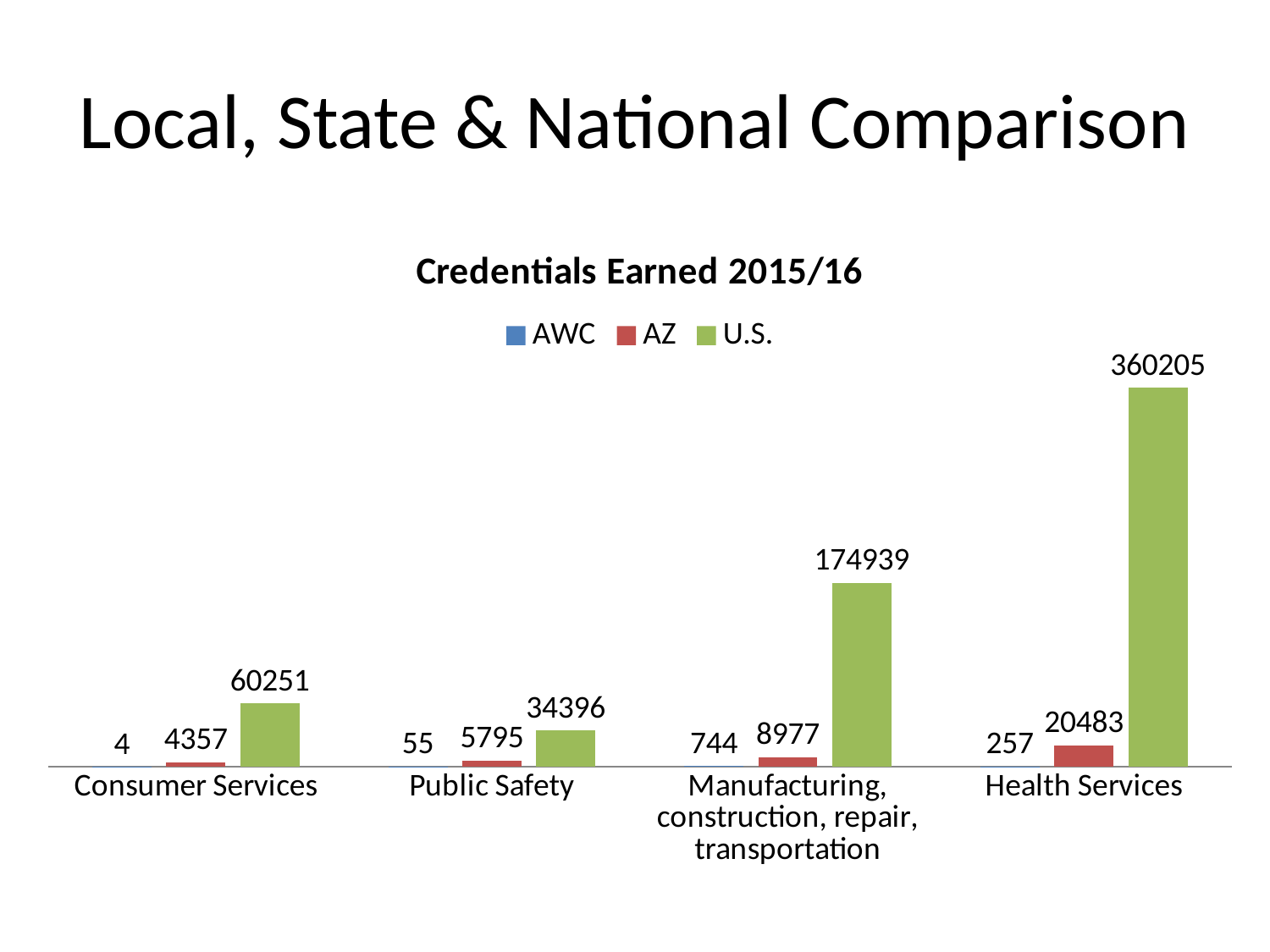
What is the title of the chart? Credentials Earned 2015/16 What kind of chart is shown? bar chart What is the AWC value for Manufacturing, construction, repair, transportation? 744 What is the AWC value for Consumer Services? 4 How many series does the legend list? 3 How many categories are shown on the x axis? 4 What is the U.S. value for Health Services? 360205 Which is larger, the AZ value for Health Services or the AZ value for Manufacturing, construction, repair, transportation? Health Services What is the difference between the U.S. values for Health Services and Manufacturing, construction, repair, transportation? 185266 Which category has the highest U.S. value? Health Services What is the AZ value for Public Safety? 5795 Which category has the lowest AZ value? Consumer Services